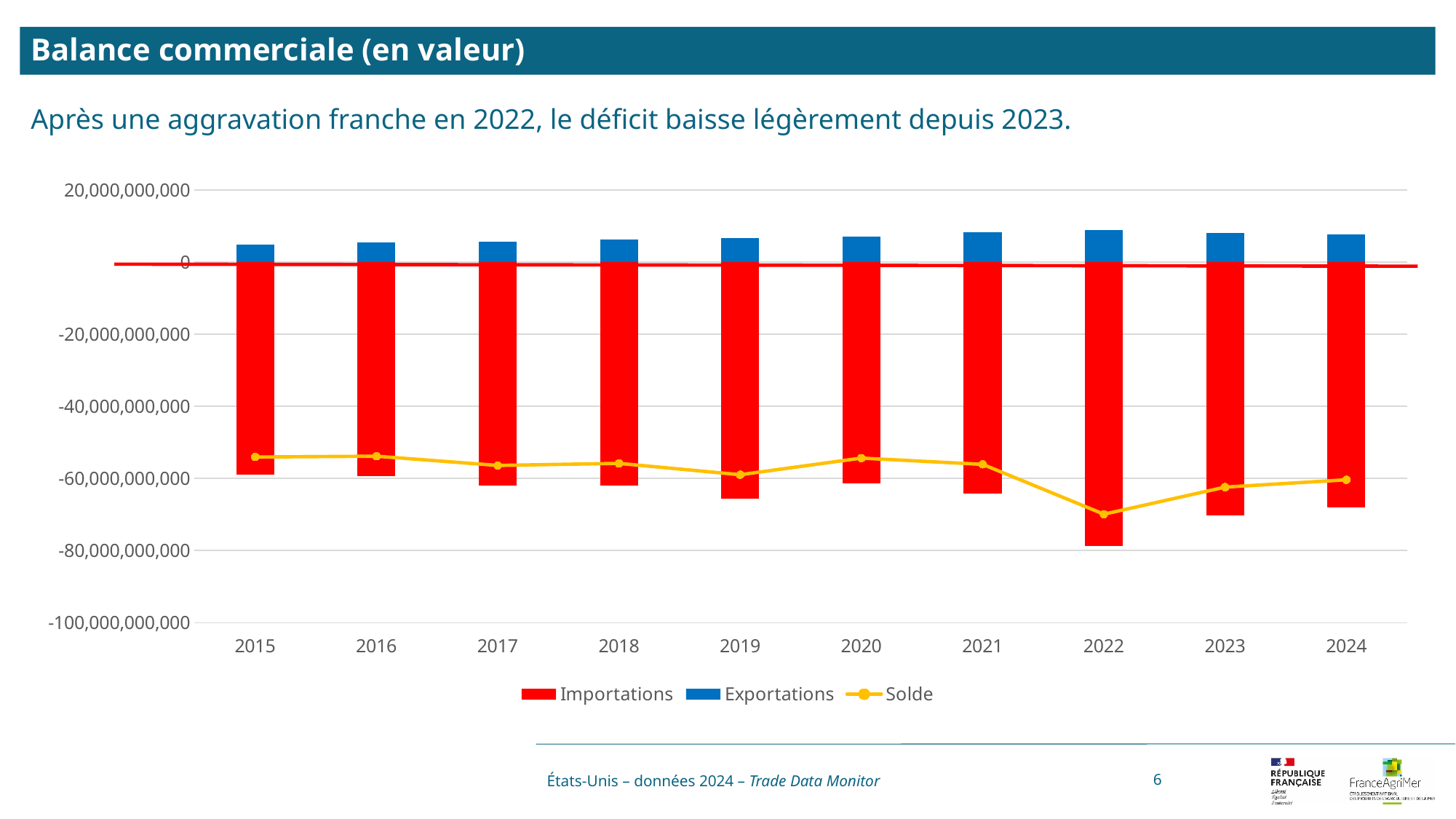
How many years are shown on the x axis of the chart? 10 How many series does the chart legend list? 3 In which year does the Importations bar reach its lowest (most negative) value? 2022 Is the Importations value for 2022 greater or less than -60,000,000,000? less Is the Exportations value for 2015 greater or less than 20,000,000,000? less Which series is drawn as a yellow line with markers? Solde What kind of chart is shown on the slide? Bar chart with a line Does the Solde line rise or fall from 2022 to 2024? rise What is the title of the slide containing the chart? Balance commerciale (en valeur) Which is lower (more negative), the Importations value for 2022 or for 2015? 2022 In which year is the Solde line at its lowest point? 2022 Is the Solde value for 2015 greater or less than -60,000,000,000? greater